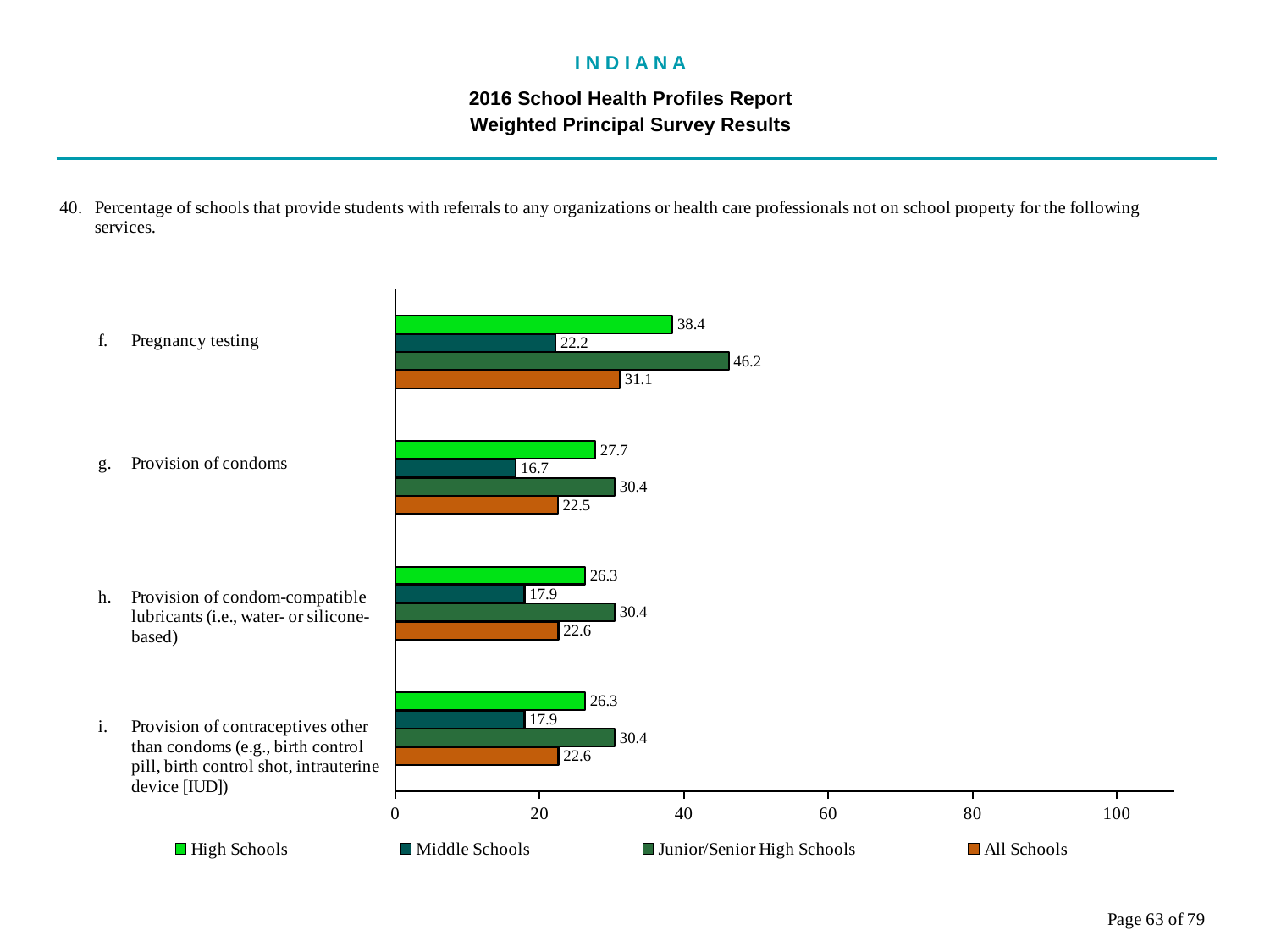
What kind of chart is shown on the slide? Bar chart What is the value for Middle Schools for Provision of condoms? 16.7 How many service categories are shown in the chart? 4 What is the value for Junior/Senior High Schools for Provision of contraceptives other than condoms? 30.4 Is the value for Junior/Senior High Schools for Pregnancy testing greater or less than 40? greater What is the difference between the Junior/Senior High Schools and Middle Schools values for Pregnancy testing? 24.0 How many series does the legend list? 4 Which school type has the highest value for Pregnancy testing? Junior/Senior High Schools Which is larger for Provision of condoms: the High Schools value or the All Schools value? High Schools What is the value for High Schools for Pregnancy testing? 38.4 Which school type has the lowest value for Provision of condoms? Middle Schools What is the value for All Schools for Provision of condom-compatible lubricants? 22.6